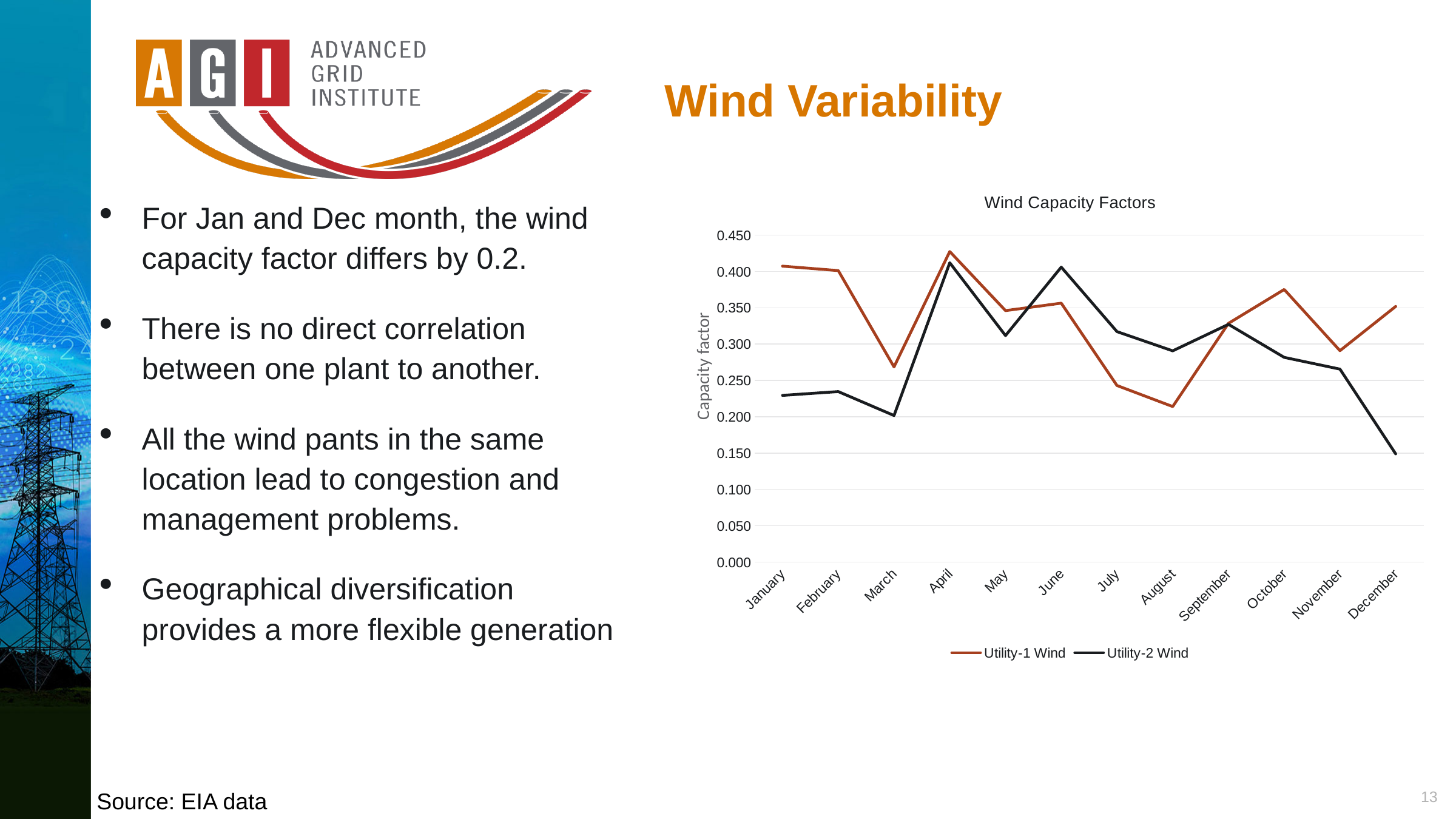
How many months are plotted along the x axis of the chart? 12 In June, which series has the higher capacity factor, Utility-1 Wind or Utility-2 Wind? Utility-2 Wind What kind of chart is shown on the slide? Line chart In which month does Utility-2 Wind have its lowest capacity factor? December In which month does Utility-1 Wind have its lowest capacity factor? August Is the value for Utility-1 Wind in August greater or less than 0.250? less In which month does Utility-1 Wind reach its highest capacity factor? April What is the title of the chart? Wind Capacity Factors Does the Utility-2 Wind line rise or fall from September to December? Fall Is the value for Utility-1 Wind in January greater or less than 0.400? greater What is the label of the vertical axis of the chart? Capacity factor How many series does the legend of the chart list? 2